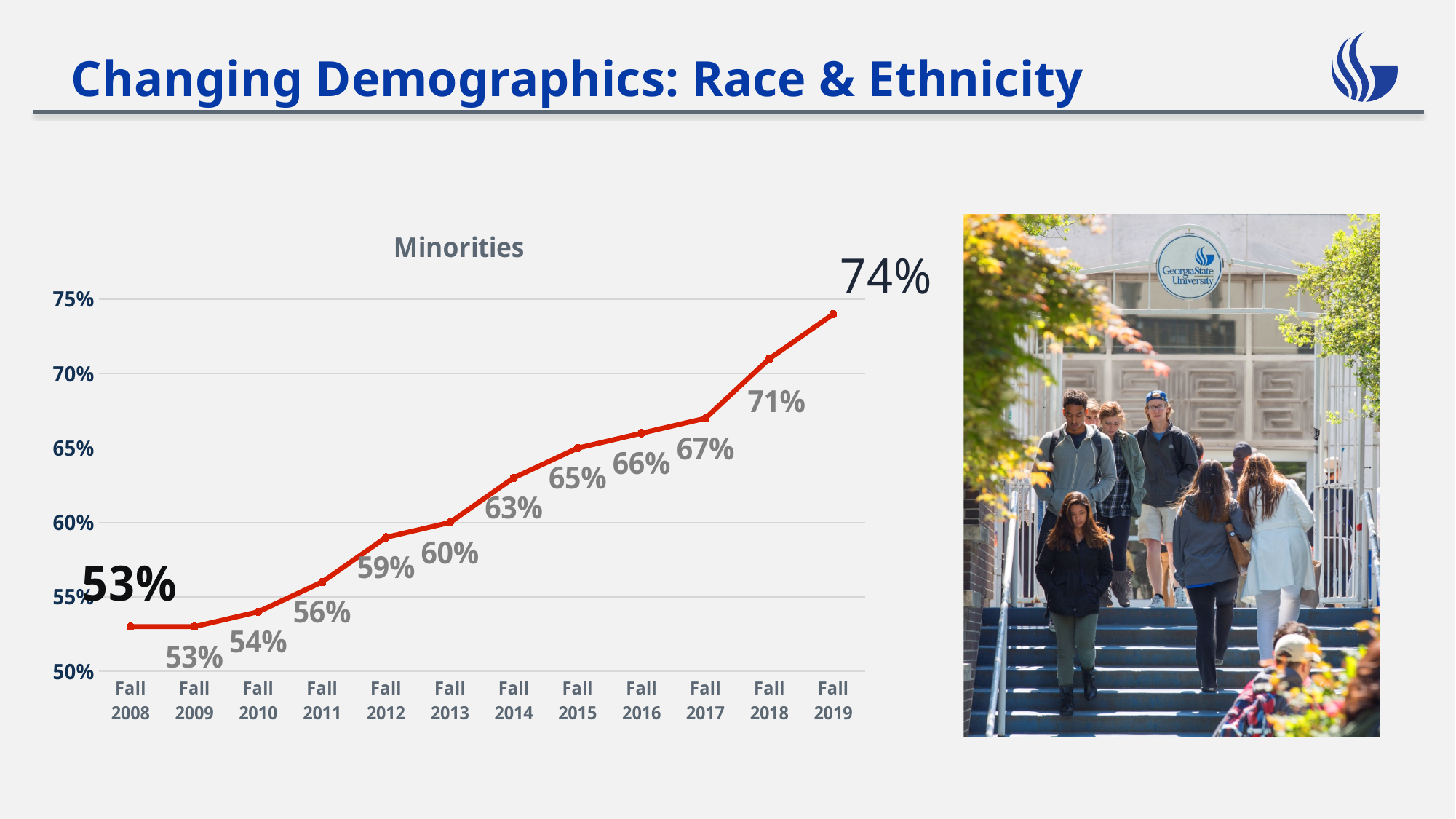
What is the title of the chart? Minorities Which year has the highest value? Fall 2019 What is the value for Fall 2016? 66% Do the values rise or fall from Fall 2008 to Fall 2019? Rise What is the value for Fall 2019? 74% Which is larger, the value for Fall 2014 or the value for Fall 2011? Fall 2014 What is the difference between the values for Fall 2019 and Fall 2008? 21% What kind of chart is shown on the slide? Line chart What is the lowest value shown on the chart? 53% What is the difference between the values for Fall 2018 and Fall 2017? 4% How many data points are plotted on the chart? 12 What is the value for Fall 2012? 59%